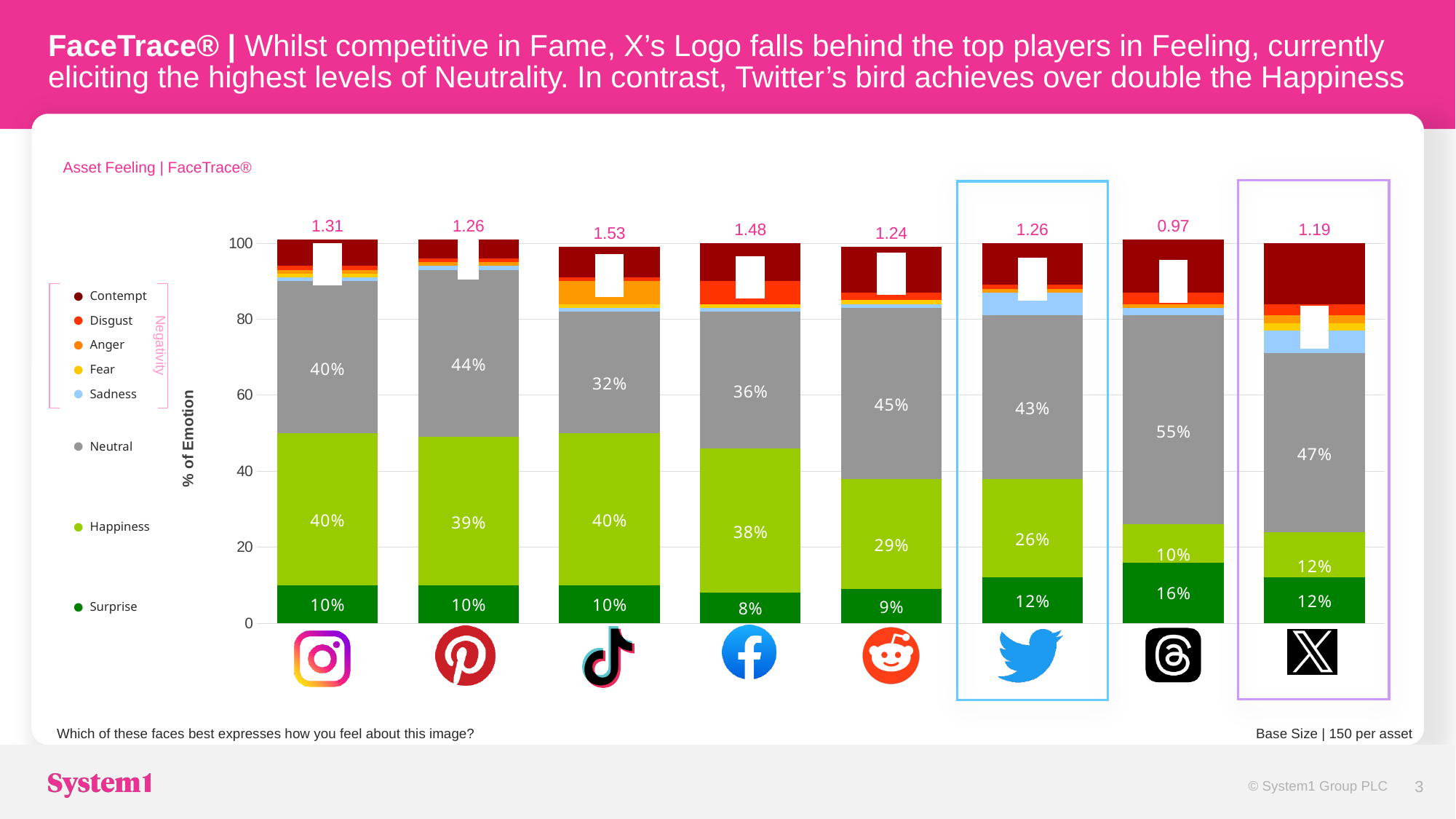
What is the Neutral value for the X logo? 47% Which asset has the lowest Surprise value? Facebook What is the Surprise value for the Threads logo? 16% How many series does the legend list? 8 What is the Happiness value for the Twitter bird logo? 26% What is the label on the y axis? % of Emotion Which asset has the highest Neutral value? Threads Which has a larger Happiness value, Instagram or Reddit? Instagram How many bars (assets) are plotted in the chart? 8 What kind of chart is shown on the slide? Stacked bar chart What is the difference between the Happiness value for Twitter and the Happiness value for X? 14% What is the number printed above the TikTok bar? 1.53